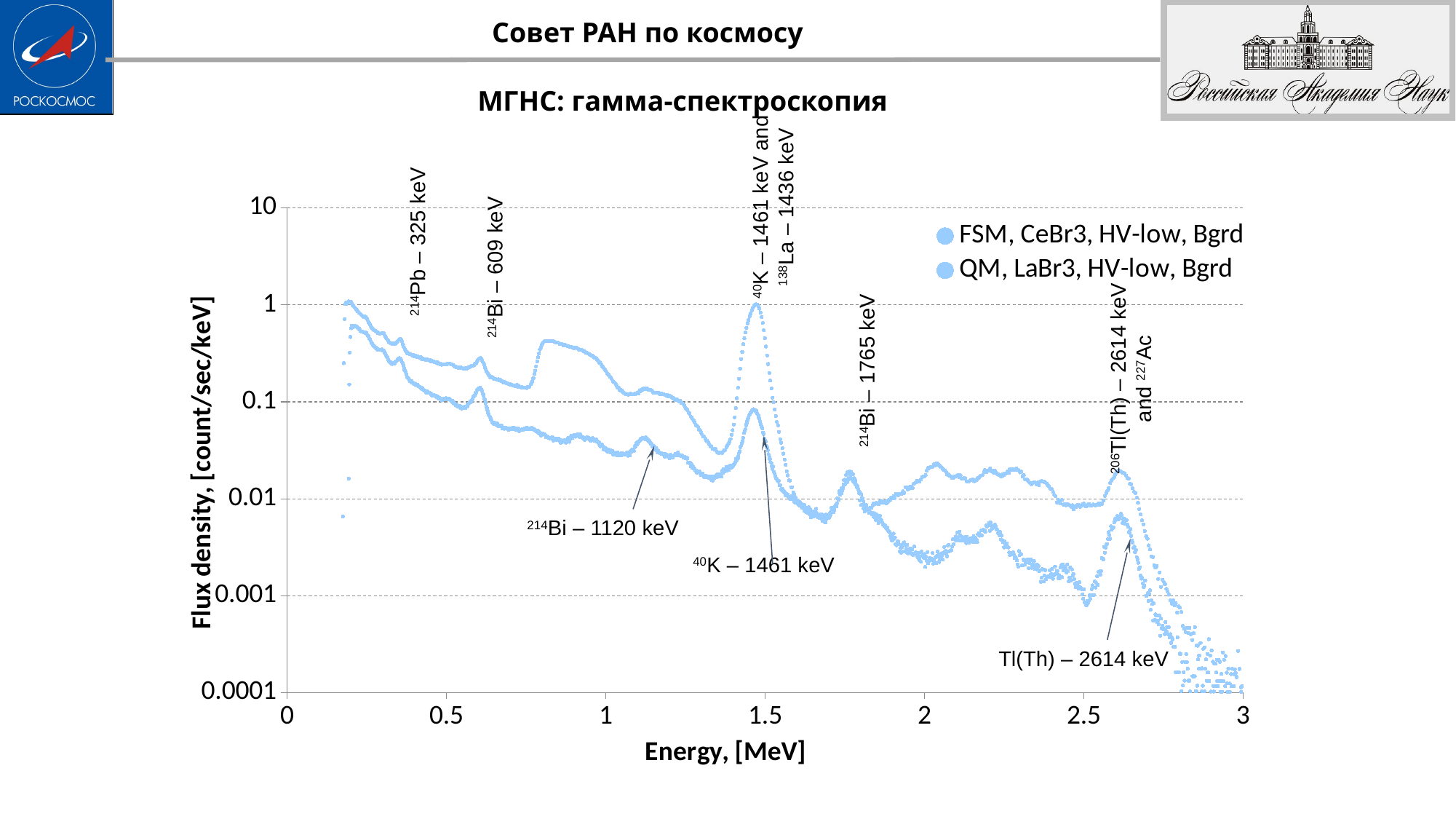
What is the title of the x axis? Energy, [MeV] Are the flux density values near 3 MeV greater or less than 0.001? less What is the maximum value shown on the y axis? 10 How many series does the legend list? 2 What kind of chart is shown on the slide? Scatter chart Is the flux density of the upper series at 2 MeV greater or less than 0.001? greater Is the highest flux density value at the peak near 1.5 MeV greater or less than 0.1? greater What is the maximum value shown on the x axis? 3 Do the flux density values generally rise or fall as energy increases from 0 to 3 MeV? Fall